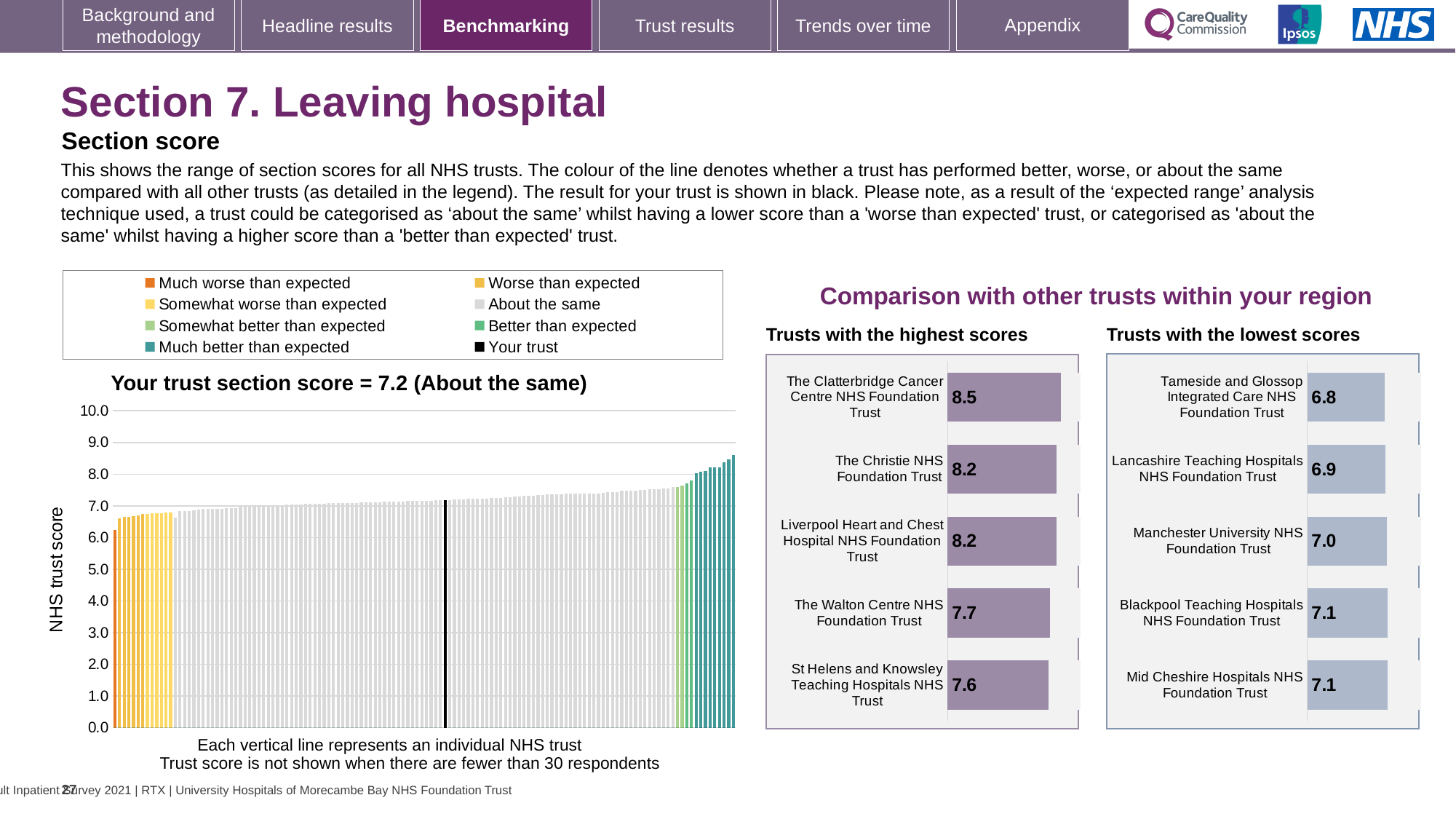
In the 'Your trust section score' chart, do the trust scores rise or fall from left to right along the x axis? rise In the 'Trusts with the lowest scores' chart, which has the higher score: Manchester University NHS Foundation Trust or Blackpool Teaching Hospitals NHS Foundation Trust? Blackpool Teaching Hospitals NHS Foundation Trust In the 'Your trust section score' chart, is the value of the tallest bar greater or less than 8.0? greater What kind of chart is the 'Your trust section score' chart? bar chart In the 'Your trust section score' chart, how many entries does the legend list? 8 In the 'Your trust section score' chart, what is the section score for your trust? 7.2 In the 'Your trust section score' chart, what colour is the bar for your trust? black In the 'Trusts with the lowest scores' chart, how many trusts are shown? 5 In the 'Trusts with the highest scores' chart, which trust has the lowest score? St Helens and Knowsley Teaching Hospitals NHS Trust In the 'Trusts with the lowest scores' chart, which trust has the lowest score? Tameside and Glossop Integrated Care NHS Foundation Trust In the 'Trusts with the highest scores' chart, what is the difference between the scores of The Clatterbridge Cancer Centre NHS Foundation Trust and St Helens and Knowsley Teaching Hospitals NHS Trust? 0.9 In the 'Trusts with the highest scores' chart, what is the score for The Clatterbridge Cancer Centre NHS Foundation Trust? 8.5